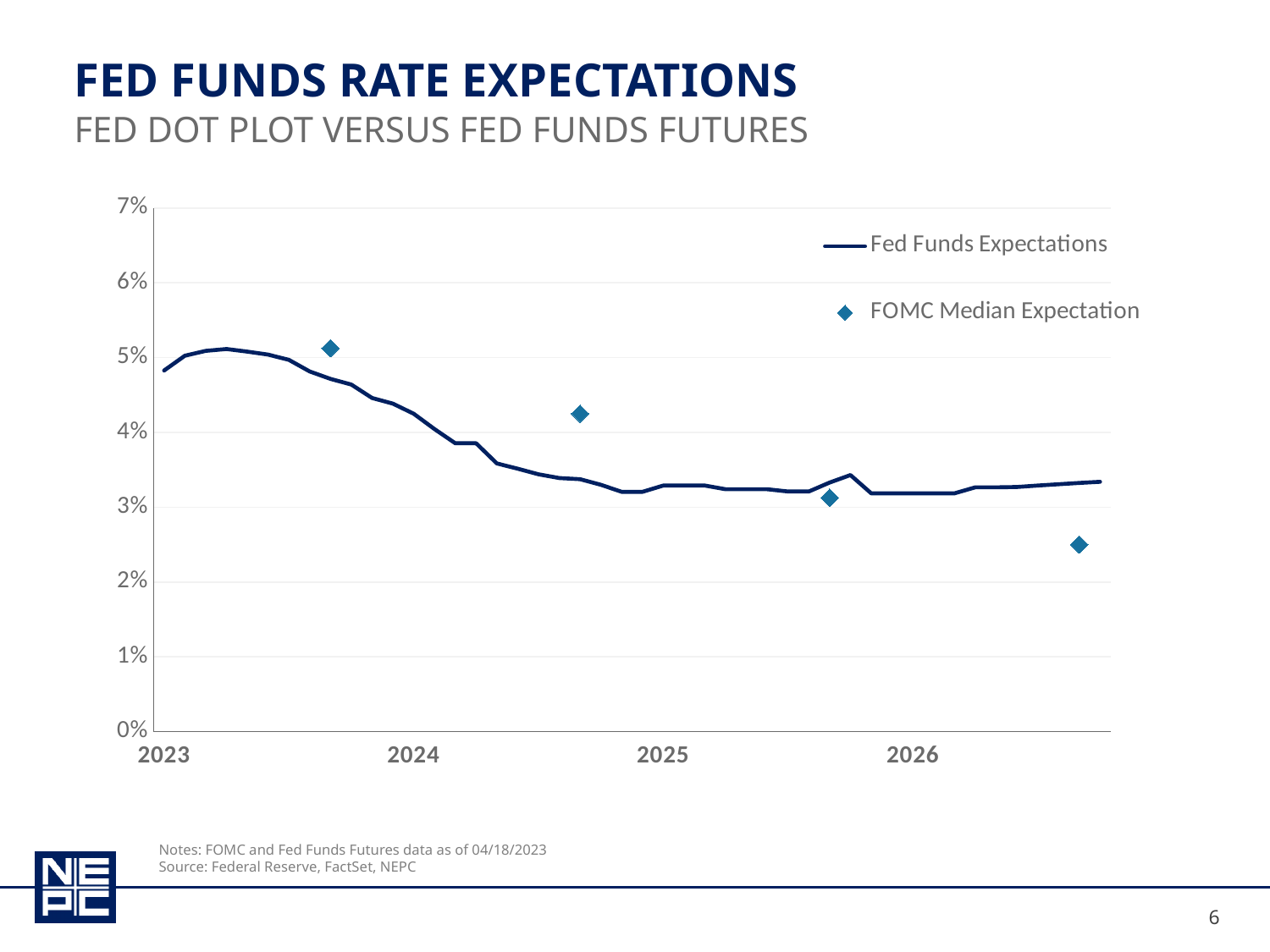
Which is larger: the FOMC Median Expectation point in 2024 or the one in 2025? 2024 Is the Fed Funds Expectations value at the end of the line in 2026 greater or less than 3%? greater How many series does the legend list? 2 Which FOMC Median Expectation point is the highest: the one in 2023 or the one in 2026? 2023 Is the FOMC Median Expectation point plotted in 2026 greater or less than 3%? less What is the subtitle of the chart slide? FED DOT PLOT VERSUS FED FUNDS FUTURES Is the FOMC Median Expectation point plotted in 2024 greater or less than 4%? greater Which year has the lowest FOMC Median Expectation point? 2026 What kind of chart is shown on the slide? line chart Does the Fed Funds Expectations line generally rise or fall from 2023 to 2026? fall How many FOMC Median Expectation points are plotted? 4